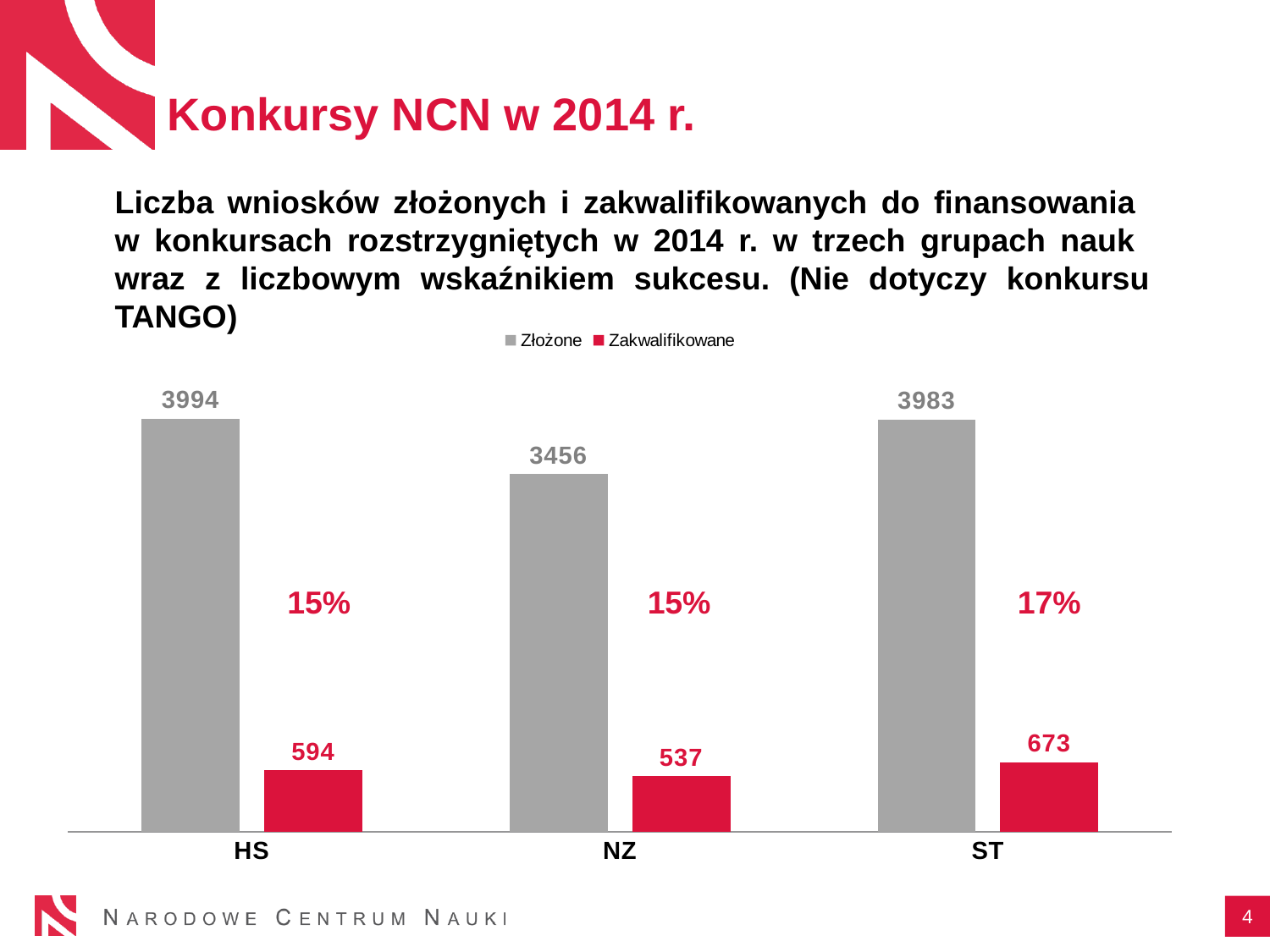
What is the value of Złożone for NZ? 3456 Which is larger, the Zakwalifikowane value for HS or for NZ? HS Which category has the lowest Zakwalifikowane value? NZ How many series does the legend list? 2 What is the value of Zakwalifikowane for ST? 673 What is the value of Zakwalifikowane for NZ? 537 What is the difference between the Złożone values for HS and NZ? 538 What is the value of Złożone for HS? 3994 Which category has the highest Złożone value? HS What kind of chart is shown on the slide? bar chart How many categories are shown on the x axis? 3 What is the difference between the Zakwalifikowane values for ST and HS? 79